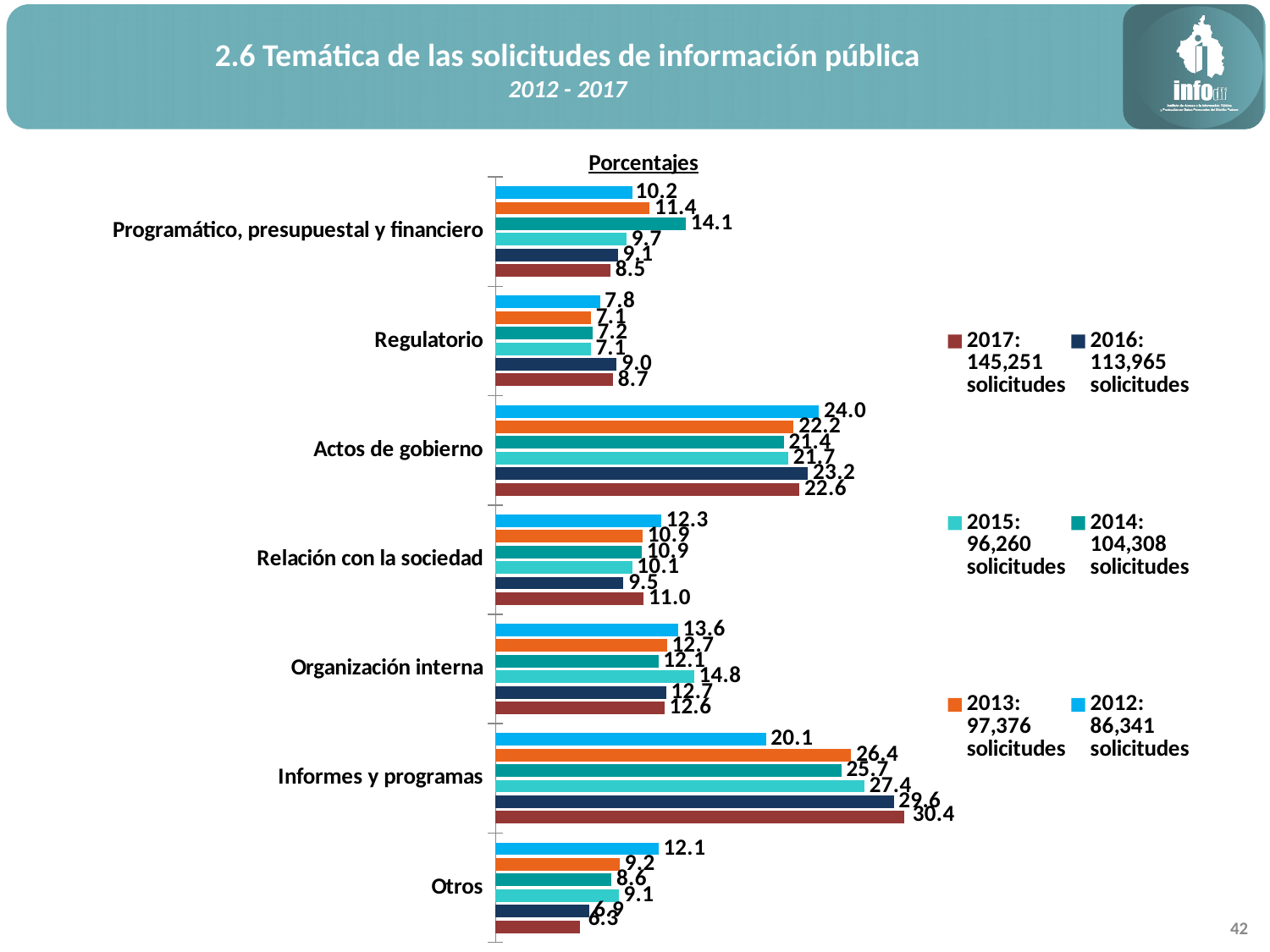
According to the legend, how many solicitudes were there in 2016? 113,965 Which category has the lowest 2012 value? Regulatorio What is the 2015 value for Organización interna? 14.8 Which is larger for Otros: the 2012 value or the 2017 value? 2012 What is the difference between the 2017 and 2012 values for Informes y programas? 10.3 What kind of chart is shown on the slide? Bar chart How many series does the legend list? 6 What is the 2017 value for Informes y programas? 30.4 Which category has the highest 2017 value? Informes y programas How many categories are shown on the chart? 7 What is the 2014 value for Programático, presupuestal y financiero? 14.1 What is the 2012 value for Actos de gobierno? 24.0